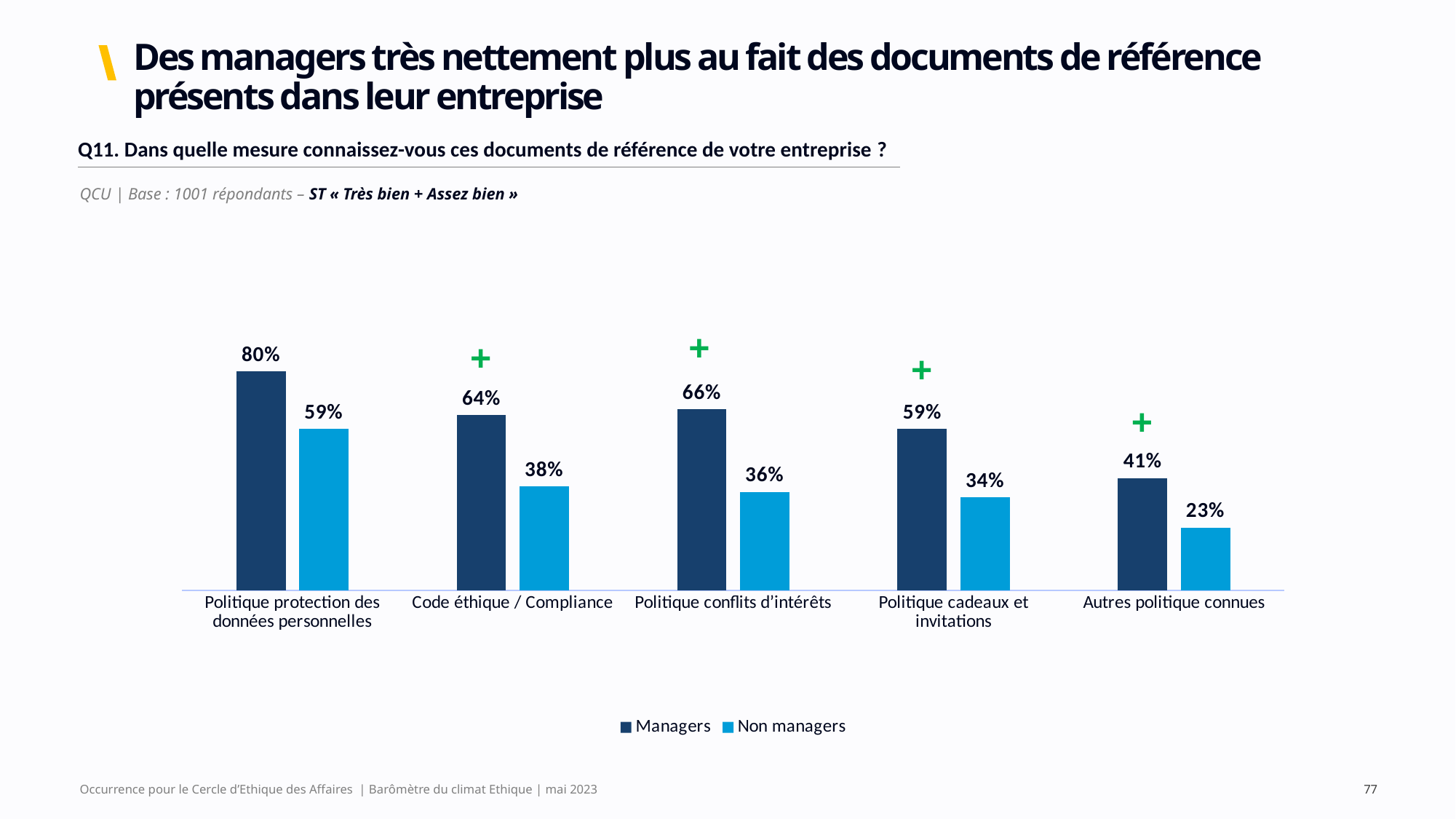
How many categories are shown on the x axis? 5 What is the difference between the Managers and Non managers values for Politique cadeaux et invitations? 25% Which category has the highest value for Managers? Politique protection des données personnelles What is the value for Managers for Politique protection des données personnelles? 80% How many series does the legend list? 2 Which category has the lowest value for Non managers? Autres politique connues What is the value for Non managers for Code éthique / Compliance? 38% What are the two series listed in the legend? Managers and Non managers What is the value for Non managers for Autres politique connues? 23% What kind of chart is shown on the slide? Bar chart What is the value for Managers for Politique conflits d'intérêts? 66% Which is larger for Code éthique / Compliance: the Managers value or the Non managers value? Managers